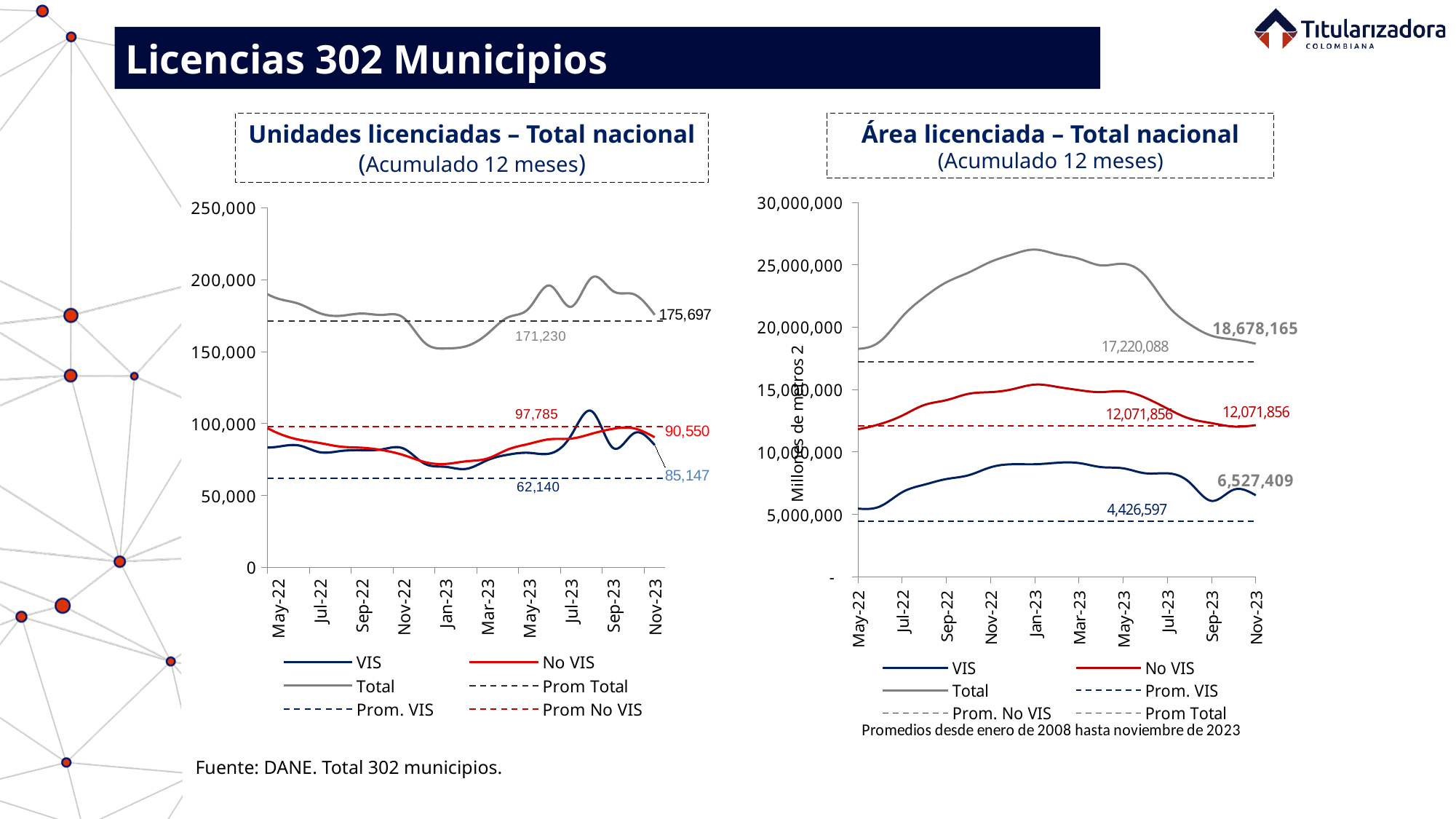
In the 'Unidades licenciadas – Total nacional' chart, what is the value of the VIS series at Nov-23? 85,147 In the 'Unidades licenciadas – Total nacional' chart, what is the difference between the No VIS and VIS values at Nov-23? 5,403 In the 'Unidades licenciadas – Total nacional' chart, what is the value of the Total series at Nov-23? 175,697 In the 'Unidades licenciadas – Total nacional' chart, what is the value of the No VIS series at Nov-23? 90,550 In the 'Área licenciada – Total nacional' chart, what is the value of the Prom. VIS line? 4,426,597 In the 'Área licenciada – Total nacional' chart, is the Total series value at Jan-23 greater or less than 25,000,000? greater In the 'Área licenciada – Total nacional' chart, what is the value of the Total series at Nov-23? 18,678,165 In the 'Área licenciada – Total nacional' chart, what is the difference between the Total value at Nov-23 and the Prom Total value? 1,458,077 In the 'Unidades licenciadas – Total nacional' chart, what is the value of the Prom Total line? 171,230 In the 'Unidades licenciadas – Total nacional' chart, which is larger at Nov-23: the Total value or the Prom Total value? Total How many series does the legend of the 'Unidades licenciadas – Total nacional' chart list? 6 What kind of chart is the 'Unidades licenciadas – Total nacional' chart? Line chart